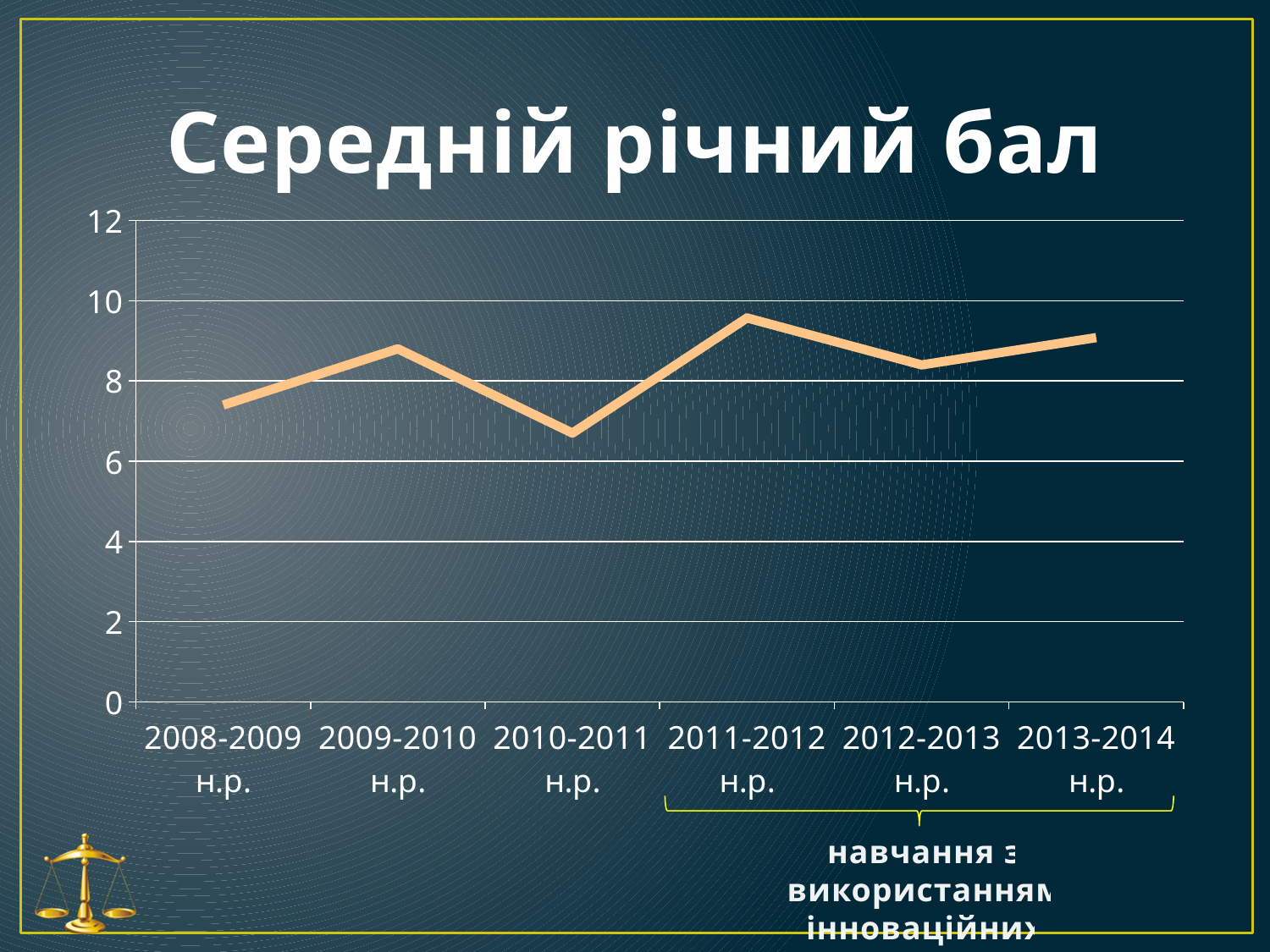
Is the value for 2013-2014 н.р. greater or less than 10? less What kind of chart is shown on the slide? line chart What is the title of the chart? Середній річний бал Is the value for 2010-2011 н.р. greater or less than 8? less Is the value for 2011-2012 н.р. greater or less than 8? greater Does the line rise or fall from 2010-2011 н.р. to 2011-2012 н.р.? rise What is the maximum value shown on the y axis? 12 Which academic year has the highest average annual score? 2011-2012 н.р. Which academic year has the lowest average annual score? 2010-2011 н.р. Which is larger, the value for 2009-2010 н.р. or the value for 2010-2011 н.р.? 2009-2010 н.р. How many academic years are plotted on the x axis? 6